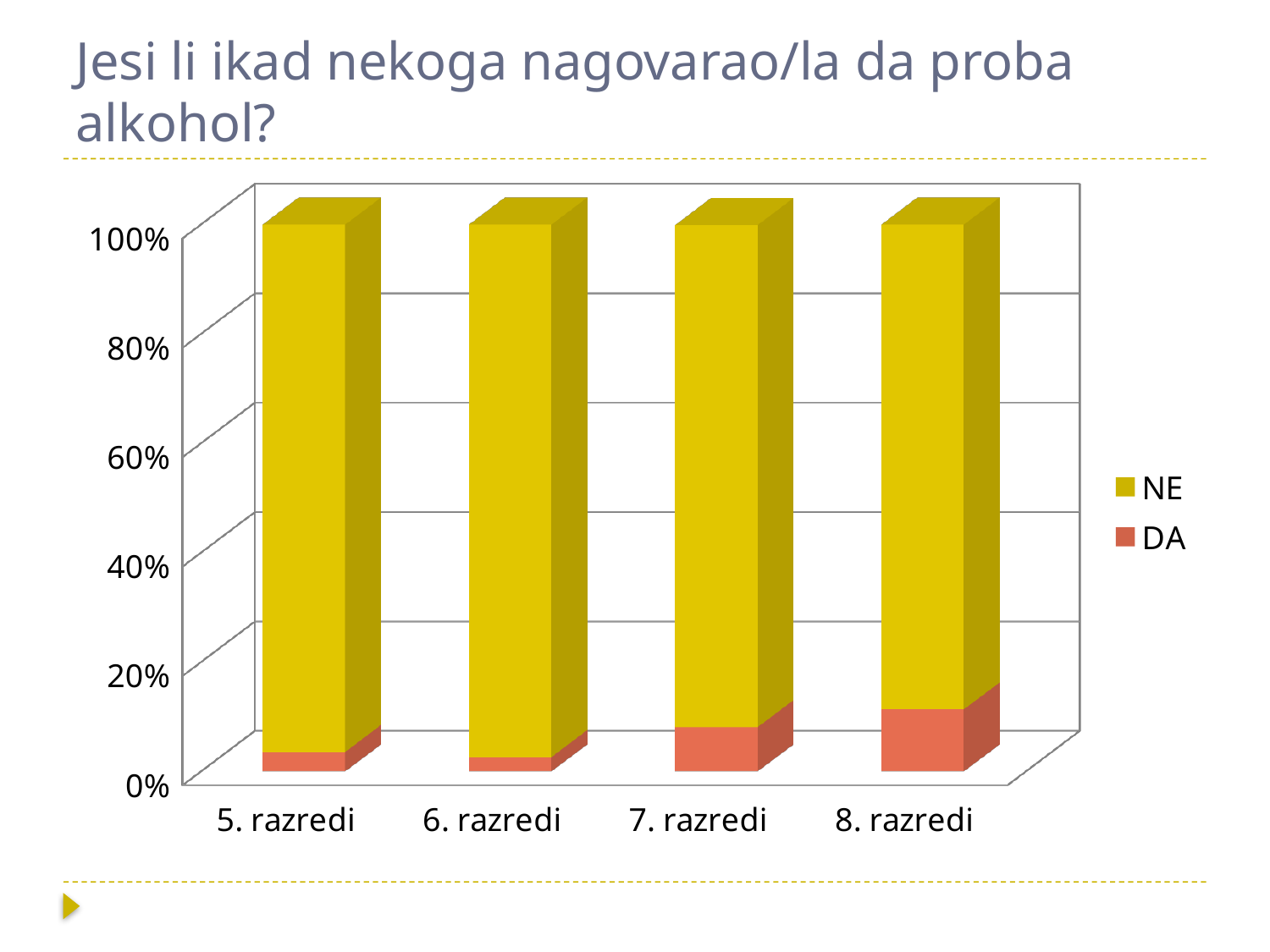
Which grade has the highest share of DA answers? 8. razredi Which colour represents the NE series? yellow How many categories (grades) are shown on the x axis? 4 Which grade has the largest NE share? 6. razredi Is the NE share for 5. razredi greater or less than 80%? greater Is the DA share for 8. razredi greater or less than 20%? less Which is larger, the DA share for 8. razredi or for 5. razredi? 8. razredi Does the share of DA answers rise or fall from 5. razredi to 8. razredi? rise What kind of chart is shown on the slide? stacked bar chart How many series does the legend list? 2 What are the two series listed in the legend? NE and DA What is the total height of the stacked bar for 7. razredi? 100%